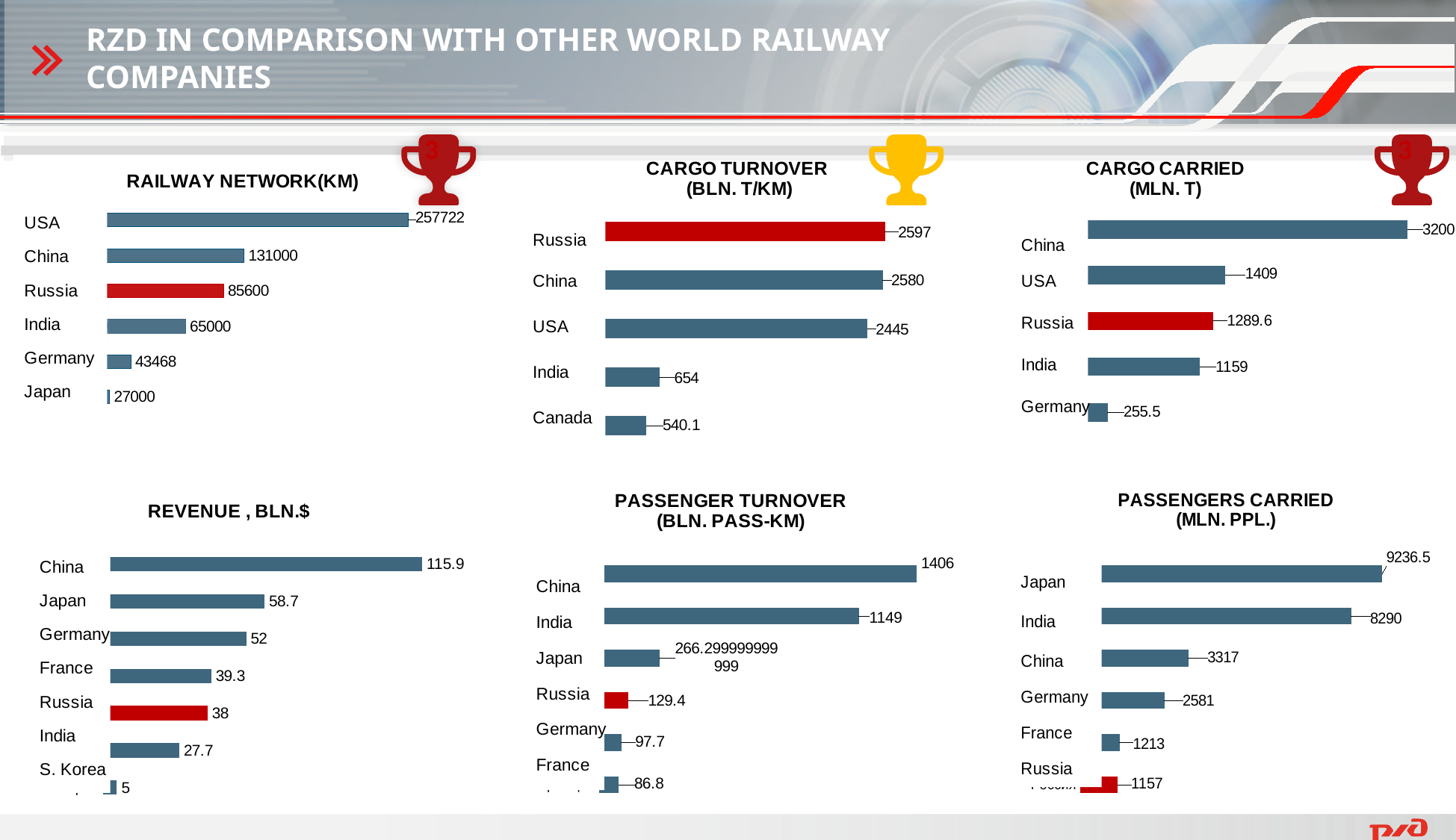
What type of chart is the Passengers Carried (MLN. PPL.) chart? Bar chart In the Railway Network (KM) chart, how many countries are shown? 6 In the Railway Network (KM) chart, which country has the largest railway network? USA In the Cargo Turnover (BLN. T/KM) chart, what is the difference between Russia and China? 17 In the Passengers Carried (MLN. PPL.) chart, which country has the highest value? Japan In the Railway Network (KM) chart, what is the value for Russia? 85600 In the Cargo Carried (MLN. T) chart, which country has the lowest value? Germany In the Revenue, BLN.$ chart, which is larger, the value for France or the value for India? France In the Cargo Carried (MLN. T) chart, what is the value for Russia? 1289.6 In the Revenue, BLN.$ chart, how many countries are listed? 7 In the Passenger Turnover (BLN. PASS-KM) chart, what is the value for Russia? 129.4 In the Cargo Turnover (BLN. T/KM) chart, what is the value for Canada? 540.1